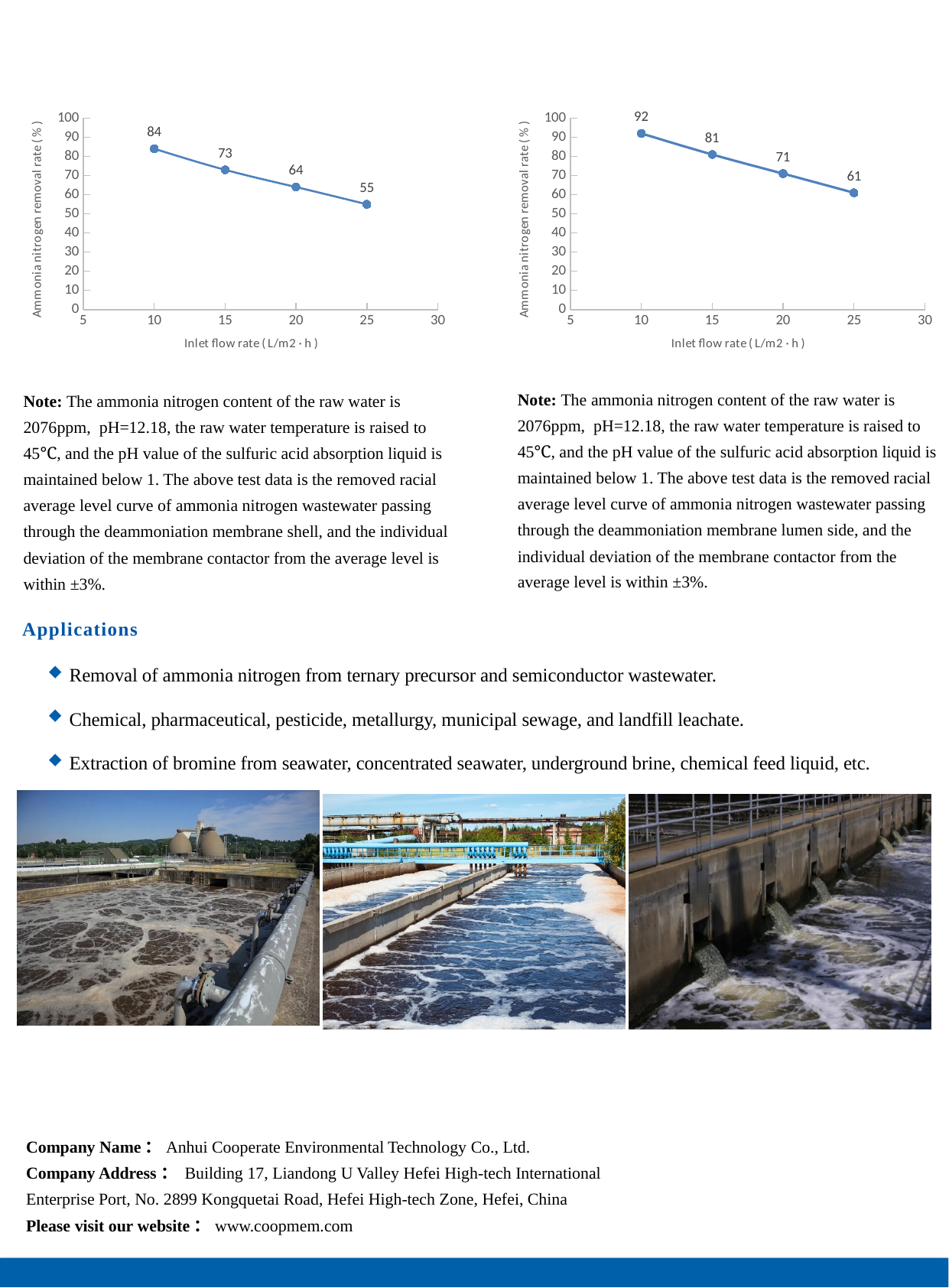
How many data points are plotted in the left chart? 4 In the right chart, what is the ammonia nitrogen removal rate at an inlet flow rate of 25? 61 In the right chart, at which inlet flow rate is the removal rate lowest? 25 In the right chart, what is the difference between the removal rate at flow rate 10 and at flow rate 20? 21 In the left chart, what is the ammonia nitrogen removal rate at an inlet flow rate of 10? 84 In the right chart, what is the ammonia nitrogen removal rate at an inlet flow rate of 15? 81 In the left chart, what is the ammonia nitrogen removal rate at an inlet flow rate of 20? 64 In the left chart, what is the difference between the removal rate at flow rate 10 and at flow rate 25? 29 Which is larger: the removal rate at flow rate 15 in the left chart or at flow rate 15 in the right chart? Right chart (81) What kind of chart is the right chart? Line chart In the left chart, at which inlet flow rate is the removal rate highest? 10 In the left chart, does the removal rate rise or fall as the inlet flow rate increases? Fall